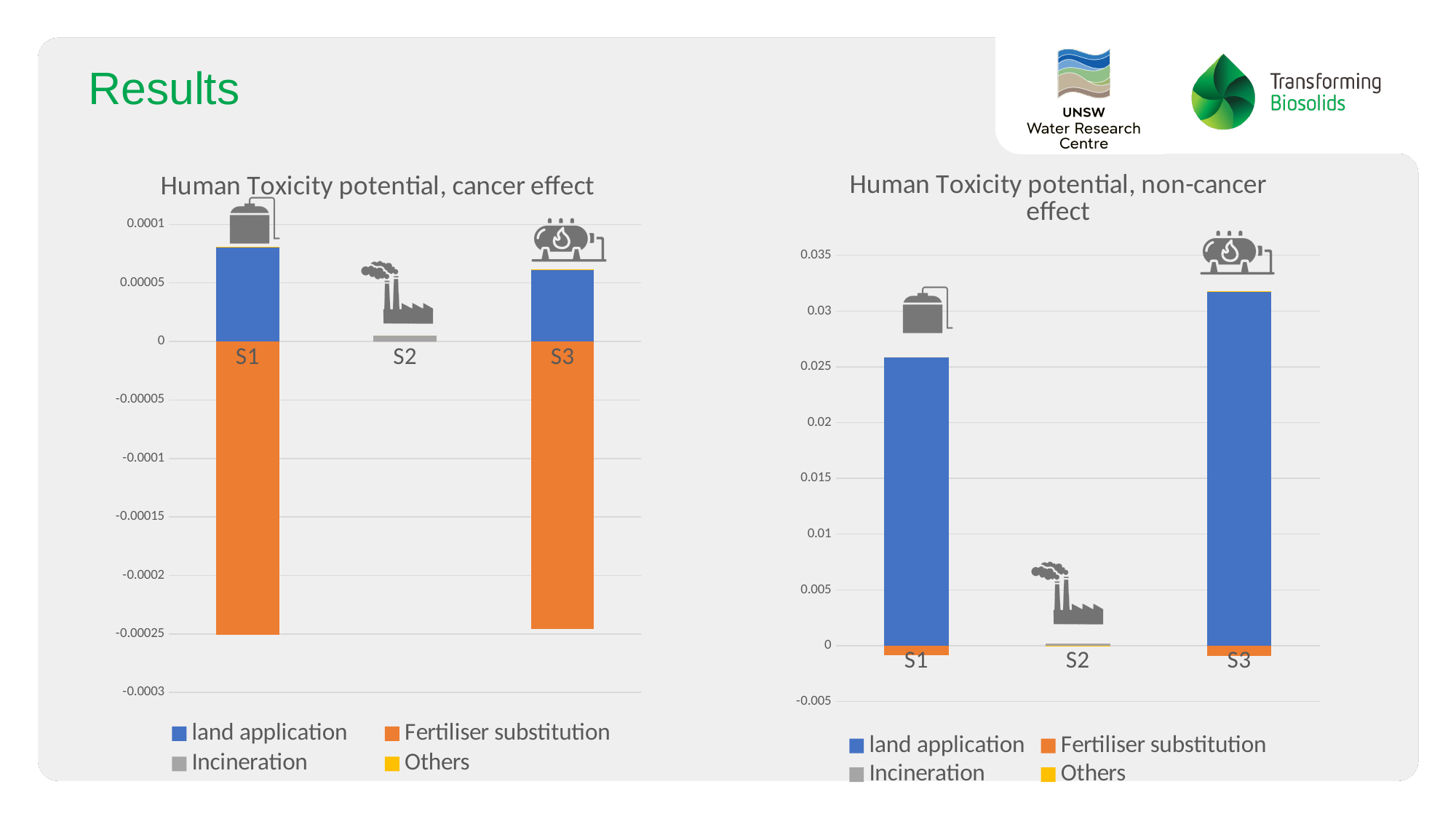
In the 'Human Toxicity potential, cancer effect' chart, which has the larger land application value, S1 or S3? S1 In the 'Human Toxicity potential, cancer effect' chart, is the Fertiliser substitution value for S1 greater or less than -0.0002? less In the 'Human Toxicity potential, cancer effect' chart, how many categories are shown on the x axis? 3 In the 'Human Toxicity potential, non-cancer effect' chart, is the land application value for S3 greater or less than 0.03? greater In the 'Human Toxicity potential, non-cancer effect' chart, how many series does the legend list? 4 In the 'Human Toxicity potential, non-cancer effect' chart, which has the larger land application value, S1 or S3? S3 In the 'Human Toxicity potential, cancer effect' chart, which colour represents Fertiliser substitution? orange In the 'Human Toxicity potential, cancer effect' chart, is the land application value for S1 greater or less than 0.00005? greater In the 'Human Toxicity potential, cancer effect' chart, what kind of chart is shown? bar chart In the 'Human Toxicity potential, cancer effect' chart, how many series does the legend list? 4 In the 'Human Toxicity potential, non-cancer effect' chart, which category has the lowest land application value? S2